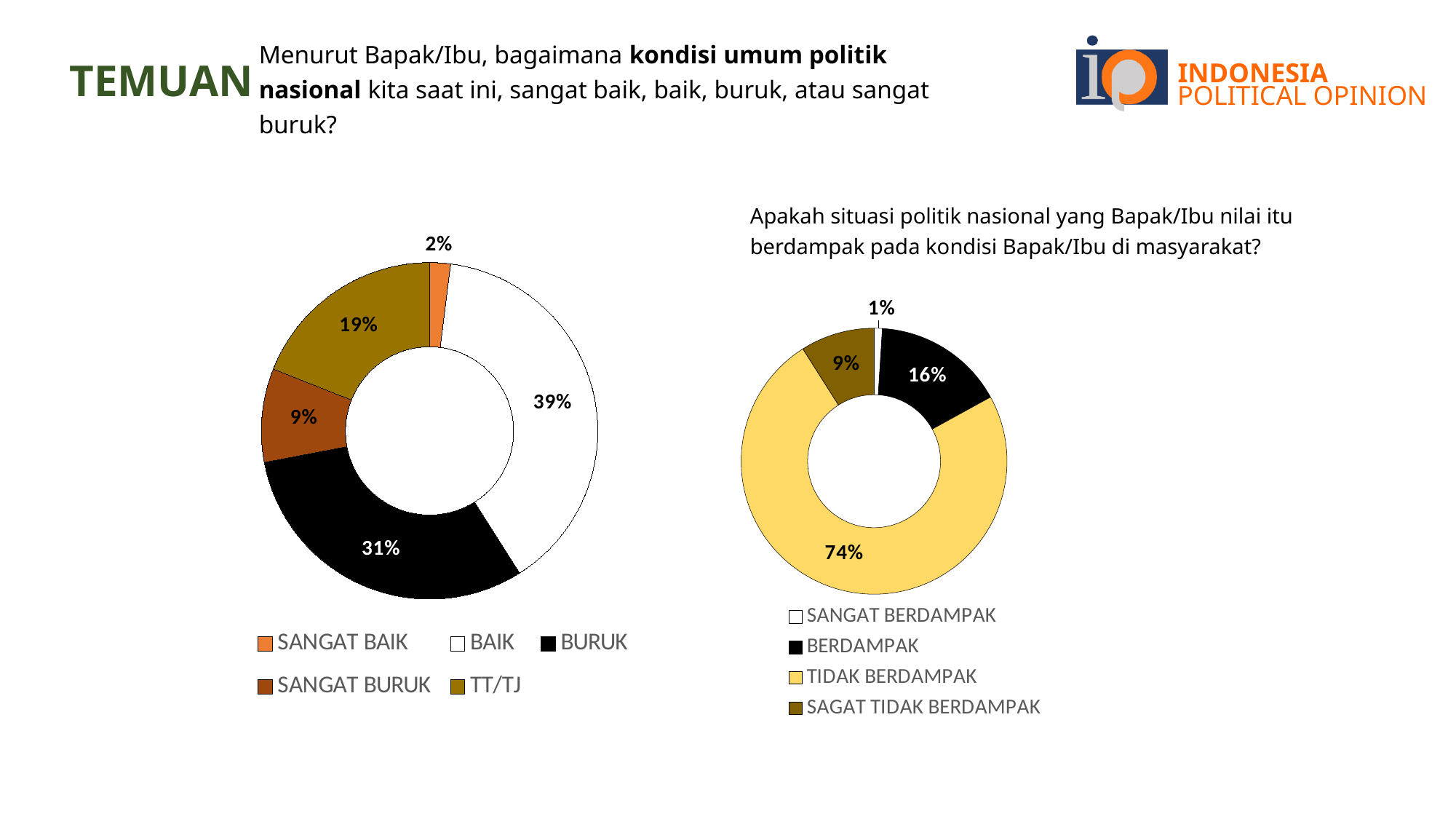
On the right chart, what colour is the TIDAK BERDAMPAK slice? Yellow On the right chart, what percentage is shown for BERDAMPAK? 16% On the left chart, what is the difference between the BAIK and BURUK shares? 8% On the left chart, which category has the smallest share? SANGAT BAIK On the right chart, what percentage is shown for TIDAK BERDAMPAK? 74% On the left chart, what percentage is shown for TT/TJ? 19% On the right chart, which category has the smallest share? SANGAT BERDAMPAK On the right chart, which is larger: BERDAMPAK or SAGAT TIDAK BERDAMPAK? BERDAMPAK On the left chart, what percentage is shown for BAIK? 39% On the left chart, which category has the largest share? BAIK What type of chart is the right chart? Donut (pie) chart On the left chart, how many categories are shown in the legend? 5